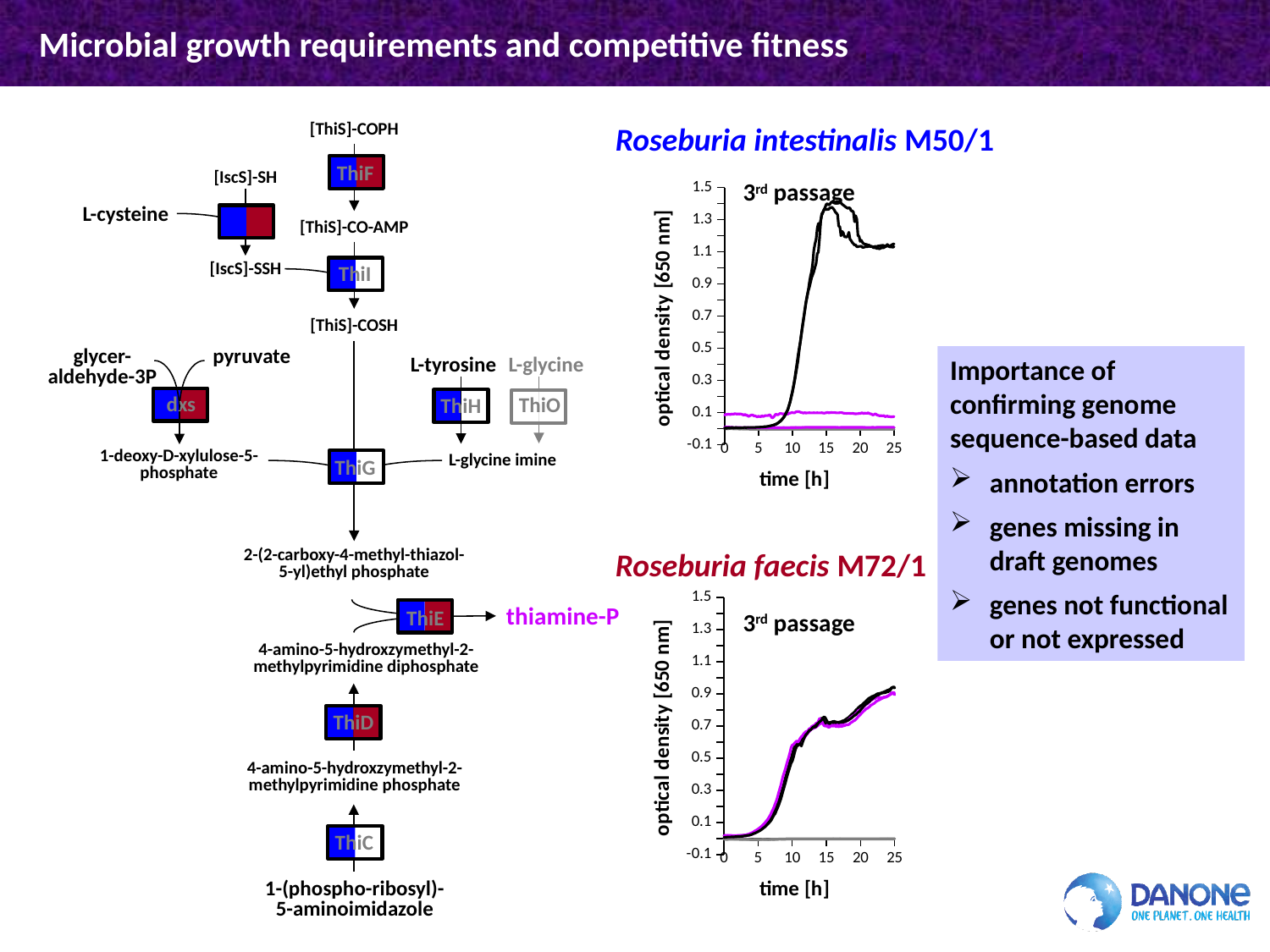
In the Roseburia intestinalis M50/1 chart, is the value of the black curve at 5 h greater or less than 0.3? less In the Roseburia intestinalis M50/1 chart, is the peak value of the black curve greater or less than 1.1? greater What kind of chart is the Roseburia intestinalis M50/1 chart? line chart In the Roseburia faecis M72/1 chart, is the value of the black curve at 25 h greater or less than 0.7? greater In the Roseburia faecis M72/1 chart, does the black curve rise or fall between 5 h and 25 h? rise What is the x-axis label on the Roseburia intestinalis M50/1 chart? time [h] Which chart's black curve reaches a higher peak optical density: Roseburia intestinalis M50/1 or Roseburia faecis M72/1? Roseburia intestinalis M50/1 In the Roseburia intestinalis M50/1 chart, at 15 h, which is higher: the black curve or the magenta curve? black curve What is the y-axis label on the Roseburia faecis M72/1 chart? optical density [650 nm]